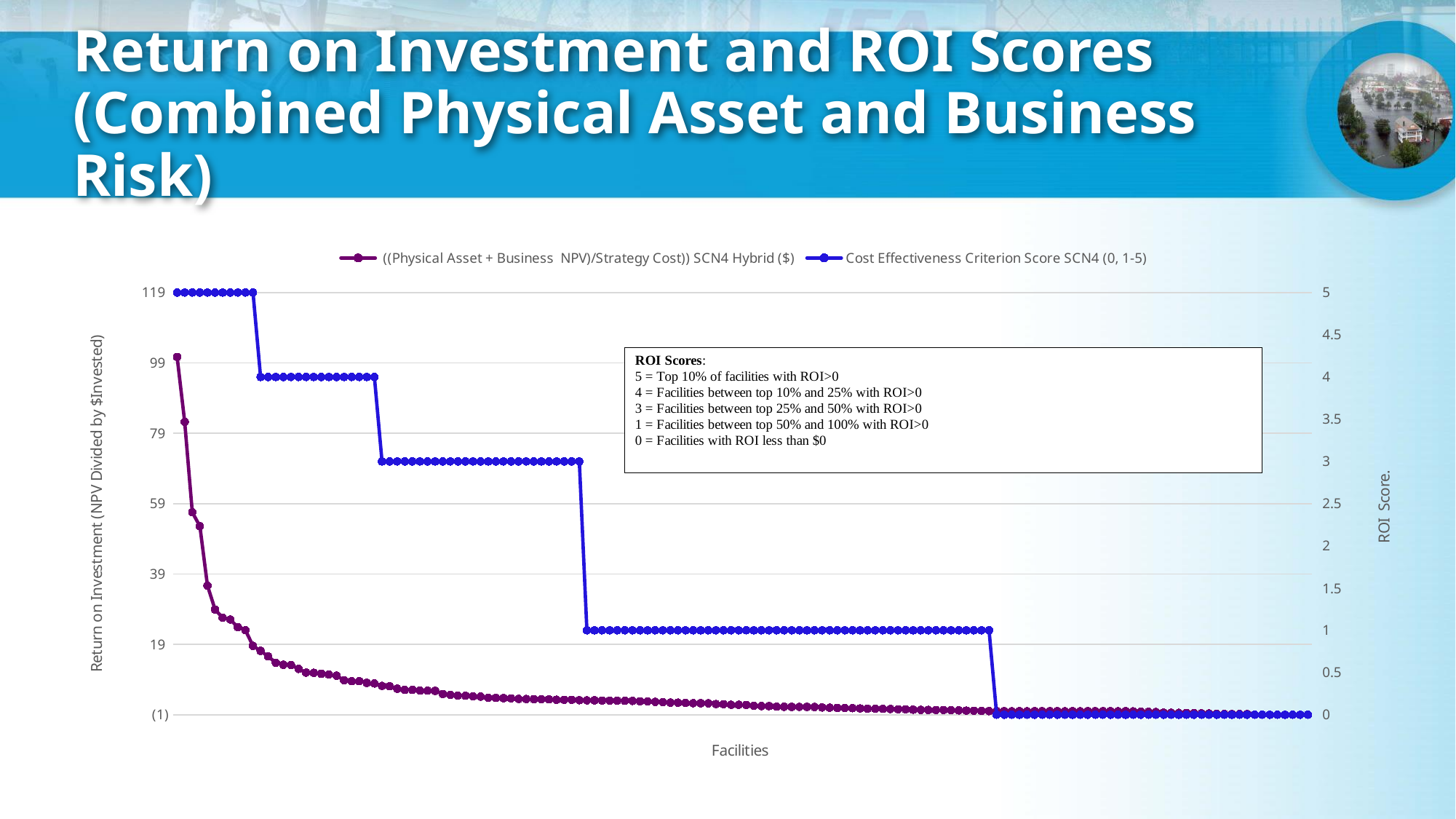
Which ROI score level does the Cost Effectiveness Criterion Score series skip between 3 and 0? 2 How many series does the chart legend list? 2 Is the Return on Investment value for the first facility on the left greater or less than 79? greater Does the Return on Investment series rise or fall as you move left to right along the x axis? fall What is the lowest ROI score value plotted for the Cost Effectiveness Criterion Score series? 0 What is the title of the x axis of the chart? Facilities What is the highest ROI score value plotted for the Cost Effectiveness Criterion Score series? 5 Is the Return on Investment value for the last facility on the right greater or less than 19? less Does the Cost Effectiveness Criterion Score series rise or fall as you move left to right along the x axis? fall What is the title of the right-hand (secondary) y axis of the chart? ROI Score. What kind of chart is shown on the slide? line chart